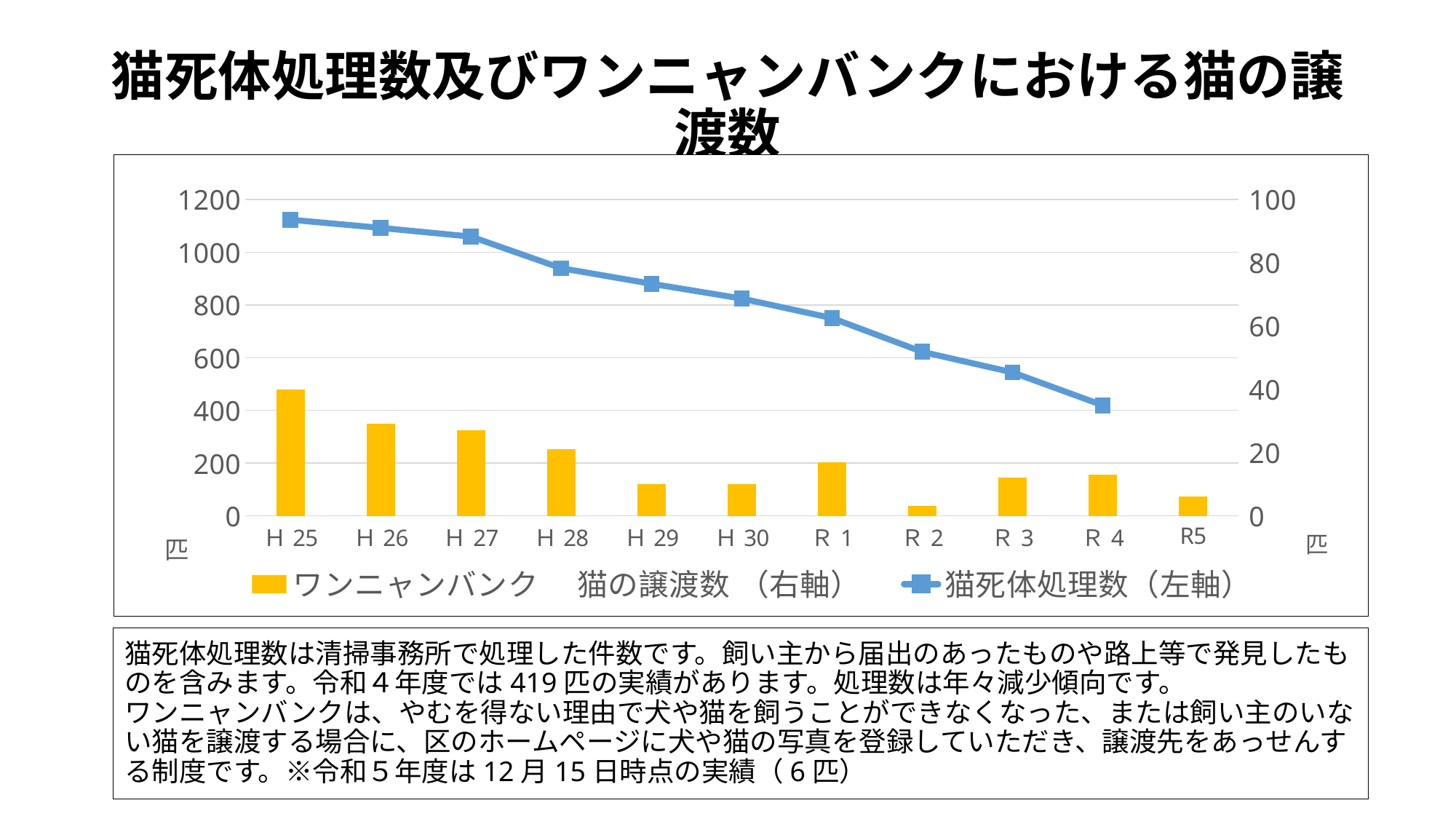
According to the legend, which axis does the 猫死体処理数 series use? 左軸 (left axis) Is the ワンニャンバンク 猫の譲渡数 bar for H25 greater or less than 20 on the right axis? greater Which year has the larger ワンニャンバンク 猫の譲渡数 bar, H26 or H29? H26 Which year has the highest bar for ワンニャンバンク 猫の譲渡数? H25 How many series does the legend list? 2 What kind of chart is shown on the slide? A combined bar and line chart Which year has the highest 猫死体処理数 value on the line? H25 Does the 猫死体処理数 line rise or fall from H25 to R4? Falls How many year categories are shown on the x axis? 11 Which year has the lowest bar for ワンニャンバンク 猫の譲渡数? R2 Is the 猫死体処理数 value for R4 greater or less than 600 on the left axis? less Is the 猫死体処理数 value for H25 greater or less than 1000 on the left axis? greater